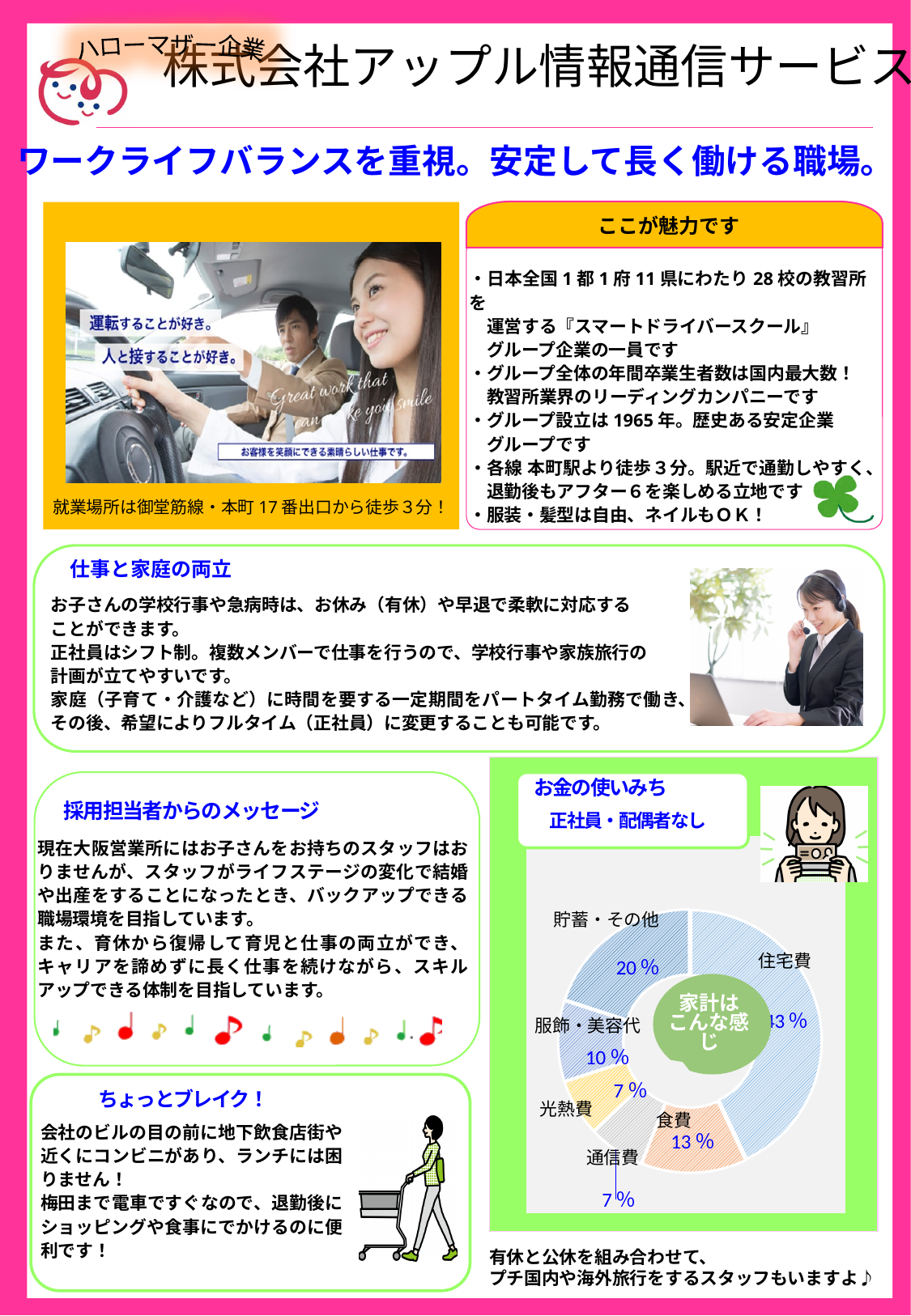
In the お金の使いみち chart, what percentage is shown for 貯蓄・その他? 20% What kind of chart is shown under the heading お金の使いみち? doughnut chart In the お金の使いみち chart, how many percentage points larger is 食費 than 通信費? 6% How many categories are shown in the お金の使いみち chart? 6 In the お金の使いみち chart, which category has the largest slice? 住宅費 What text is written in the centre of the お金の使いみち chart? 家計はこんな感じ In the お金の使いみち chart, what percentage is shown for 食費? 13% In the お金の使いみち chart, which is larger, 貯蓄・その他 or 食費? 貯蓄・その他 In the お金の使いみち chart, what percentage is shown for 光熱費? 7% In the お金の使いみち chart, how many percentage points larger is 貯蓄・その他 than 服飾・美容代? 10% In the お金の使いみち chart, what percentage is shown for 服飾・美容代? 10% In the お金の使いみち chart, what percentage is shown for 通信費? 7%